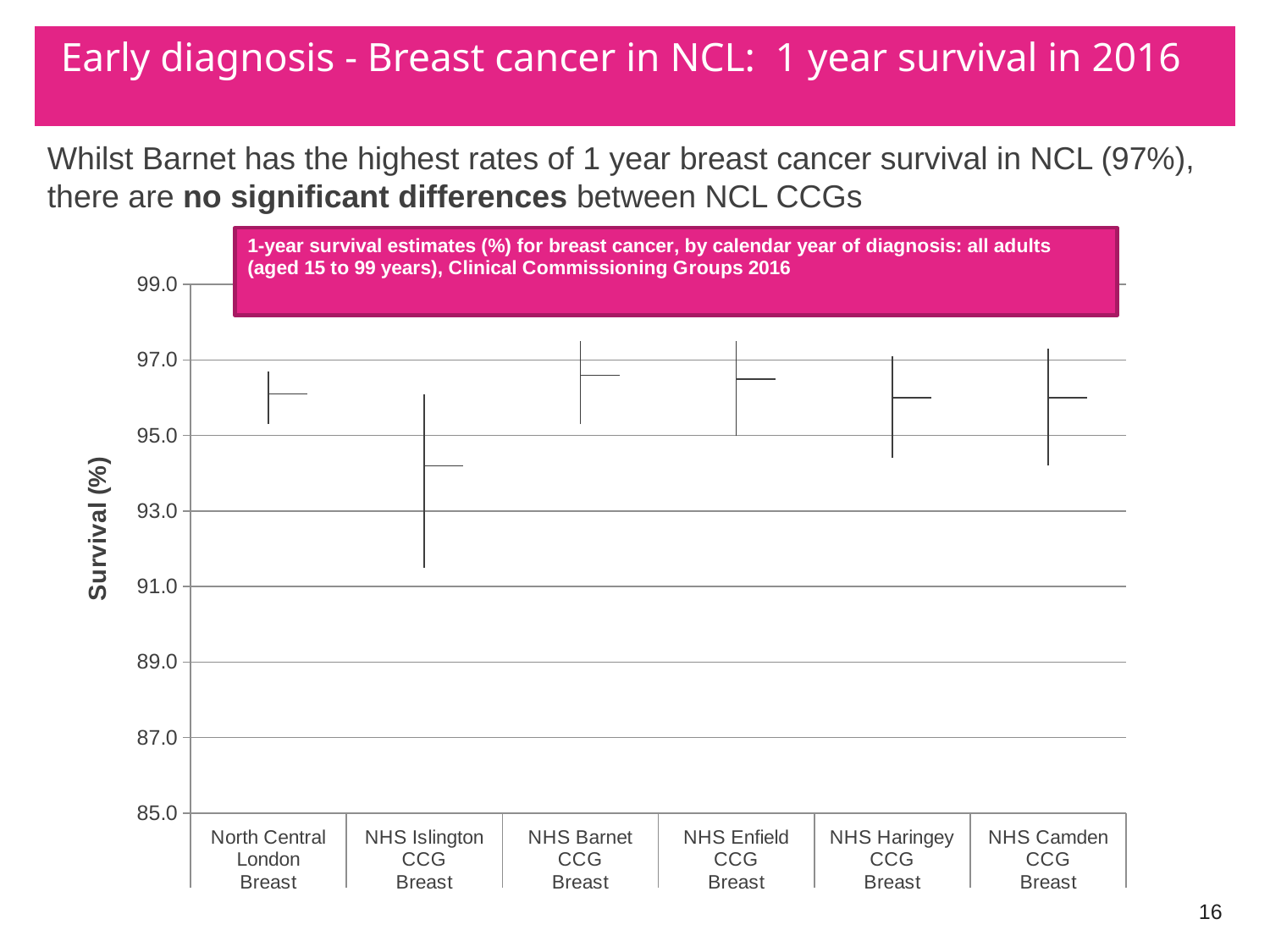
Which has the higher survival estimate, NHS Enfield CCG or NHS Islington CCG? NHS Enfield CCG Is the survival estimate for North Central London greater or less than 95.0? greater Which has the higher survival estimate, NHS Barnet CCG or NHS Islington CCG? NHS Barnet CCG What is the lowest value shown on the vertical axis of the chart? 85.0 Is the survival estimate for NHS Camden CCG greater or less than 97.0? less Is the survival estimate for NHS Islington CCG greater or less than 93.0? greater Which CCG has the lowest 1-year survival estimate on the chart? NHS Islington CCG What is the label on the vertical axis of the chart? Survival (%) How many CCG categories are plotted on the chart? 6